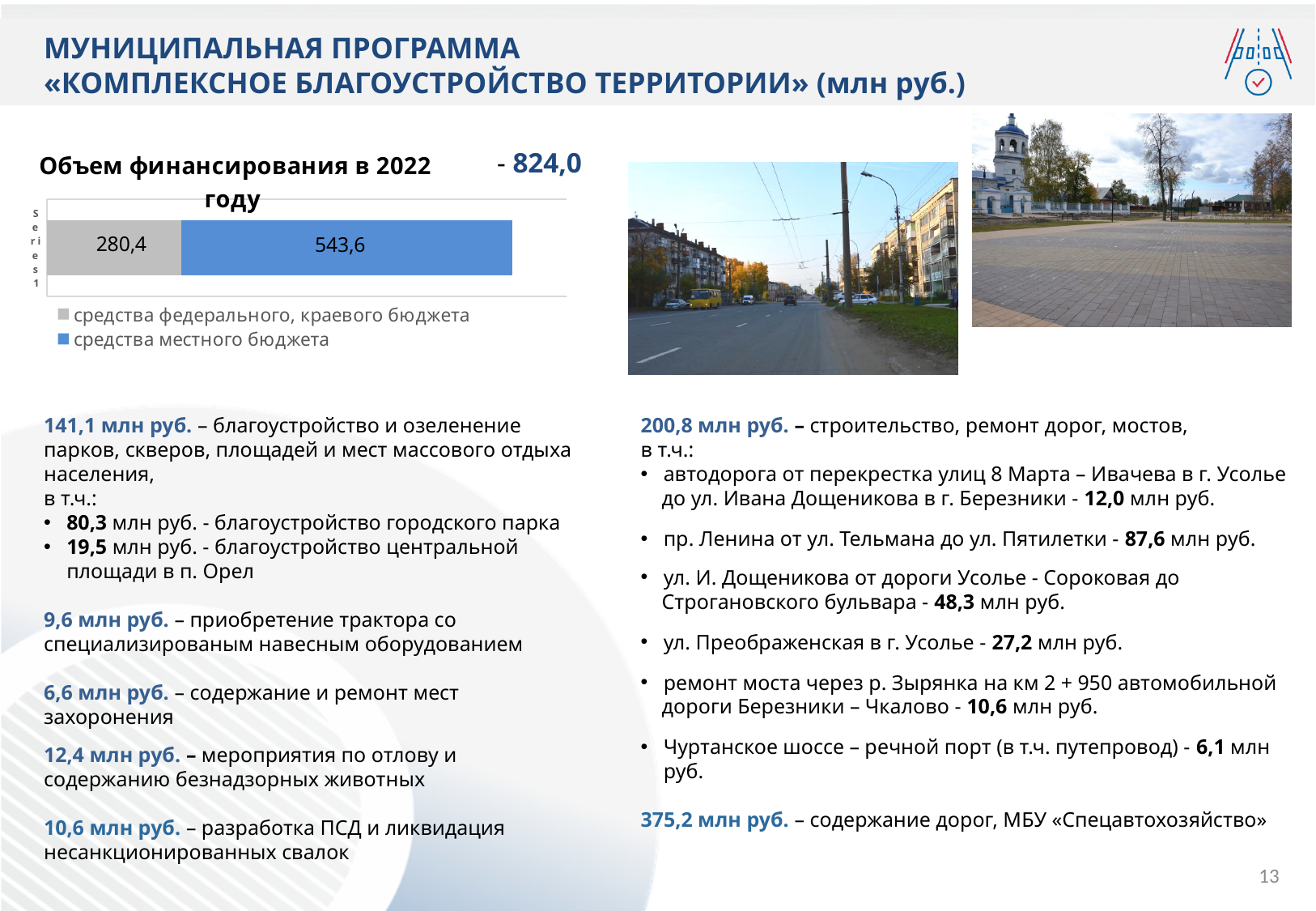
What is the difference between средства местного бюджета and средства федерального, краевого бюджета? 263,2 How many bars does the chart contain? 1 What is the total of the stacked bar in the chart? 824,0 Which colour represents средства местного бюджета in the chart? blue What is the value for средства федерального, краевого бюджета in the chart? 280,4 What kind of chart is shown on the slide? stacked bar chart Which series has the larger value: средства местного бюджета or средства федерального, краевого бюджета? средства местного бюджета Which series has the largest value in the chart? средства местного бюджета What is the title of the chart? Объем финансирования в 2022 году Which series has the smallest value in the chart? средства федерального, краевого бюджета How many series does the chart legend list? 2 What is the value for средства местного бюджета in the chart? 543,6